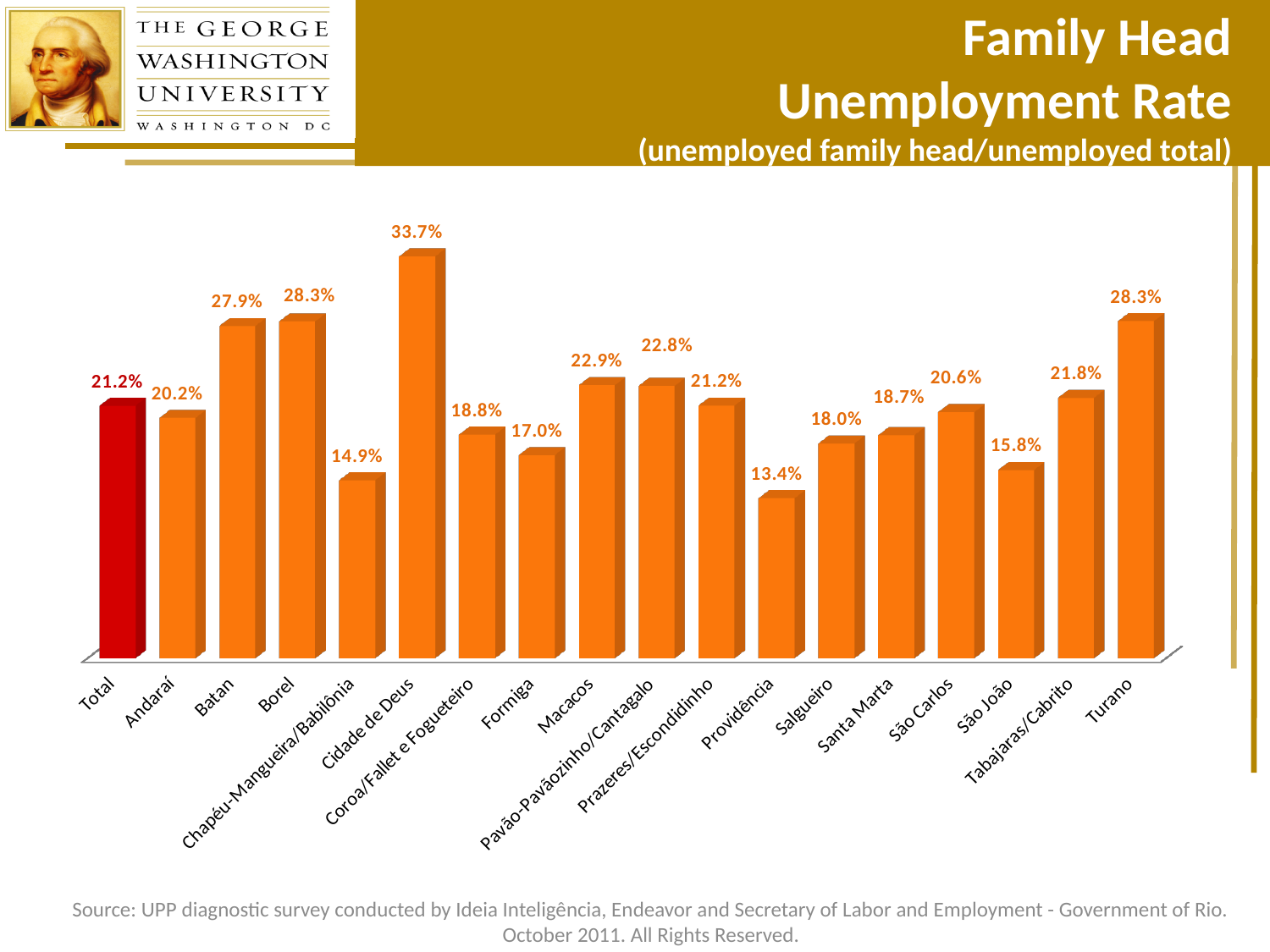
What is the value shown for Providência? 13.4% What is the difference between the values for Batan and Andaraí? 7.7% Which community has the highest family head unemployment rate? Cidade de Deus Which is larger, the value for Macacos or the value for Formiga? Macacos What is the family head unemployment rate for Cidade de Deus? 33.7% How many bars are shown in the chart? 18 What kind of chart is shown on the slide? Bar chart What is the difference between the values for Cidade de Deus and Providência? 20.3% What is the family head unemployment rate for Tabajaras/Cabrito? 21.8% What is the value shown for the Total bar? 21.2% Which community has the lowest family head unemployment rate? Providência Which bar is coloured differently (red) from the others? Total